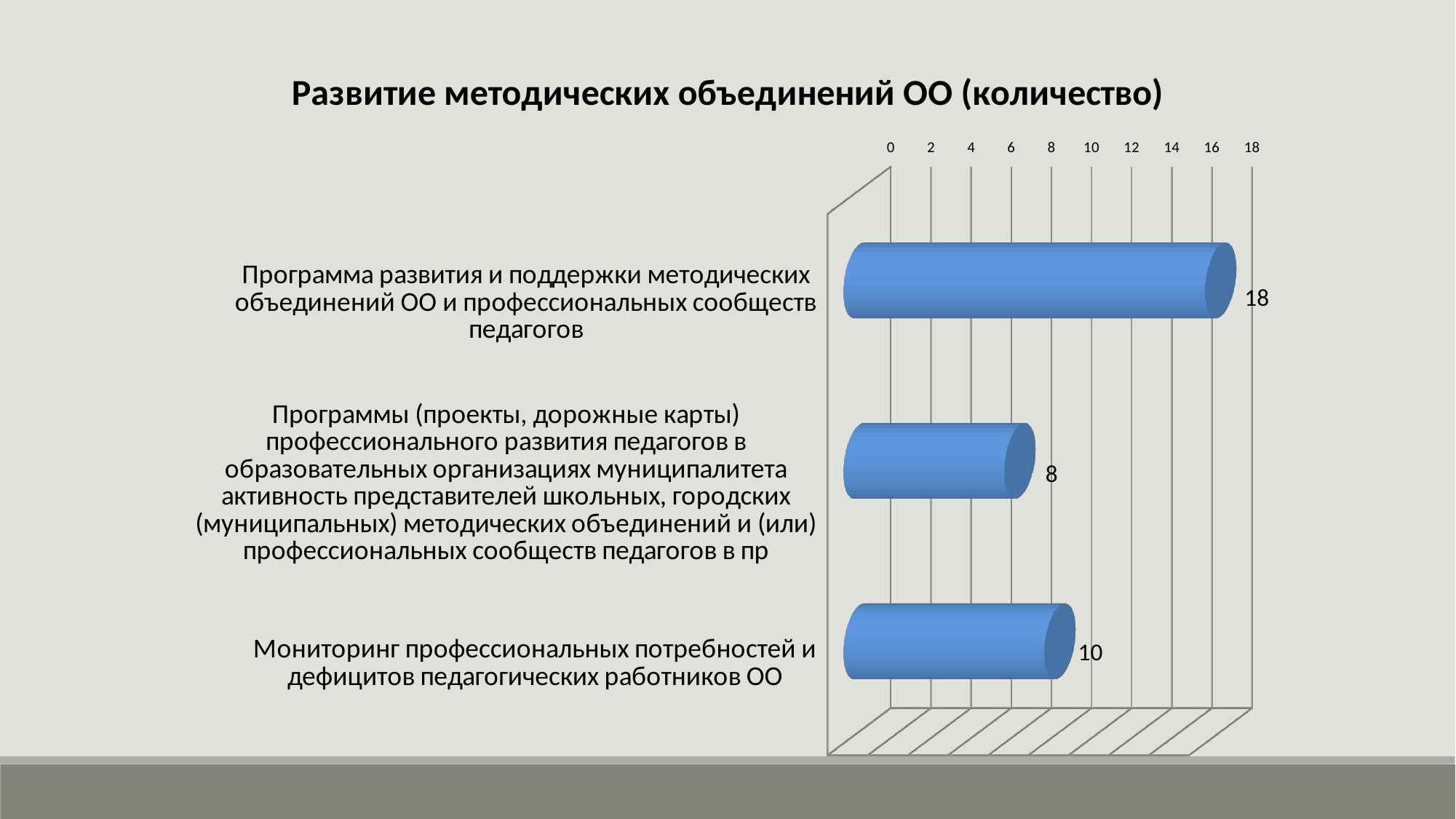
What is the value for "Программа развития и поддержки методических объединений ОО и профессиональных сообществ педагогов"? 18 What is the difference between the value for "Программа развития и поддержки методических объединений ОО и профессиональных сообществ педагогов" and the value for "Мониторинг профессиональных потребностей и дефицитов педагогических работников ОО"? 8 What is the title of the chart? Развитие методических объединений ОО (количество) Which is larger: the value for "Мониторинг профессиональных потребностей и дефицитов педагогических работников ОО" or the value for the category beginning "Программы (проекты, дорожные карты)"? Мониторинг профессиональных потребностей и дефицитов педагогических работников ОО Is the value for "Программа развития и поддержки методических объединений ОО и профессиональных сообществ педагогов" greater or less than 14? greater How many categories are shown in the chart? 3 What is the value for the category beginning "Программы (проекты, дорожные карты) профессионального развития педагогов"? 8 What is the value for "Мониторинг профессиональных потребностей и дефицитов педагогических работников ОО"? 10 What is the maximum value shown on the value axis? 18 What kind of chart is shown on the slide? bar chart Which category has the highest value? Программа развития и поддержки методических объединений ОО и профессиональных сообществ педагогов